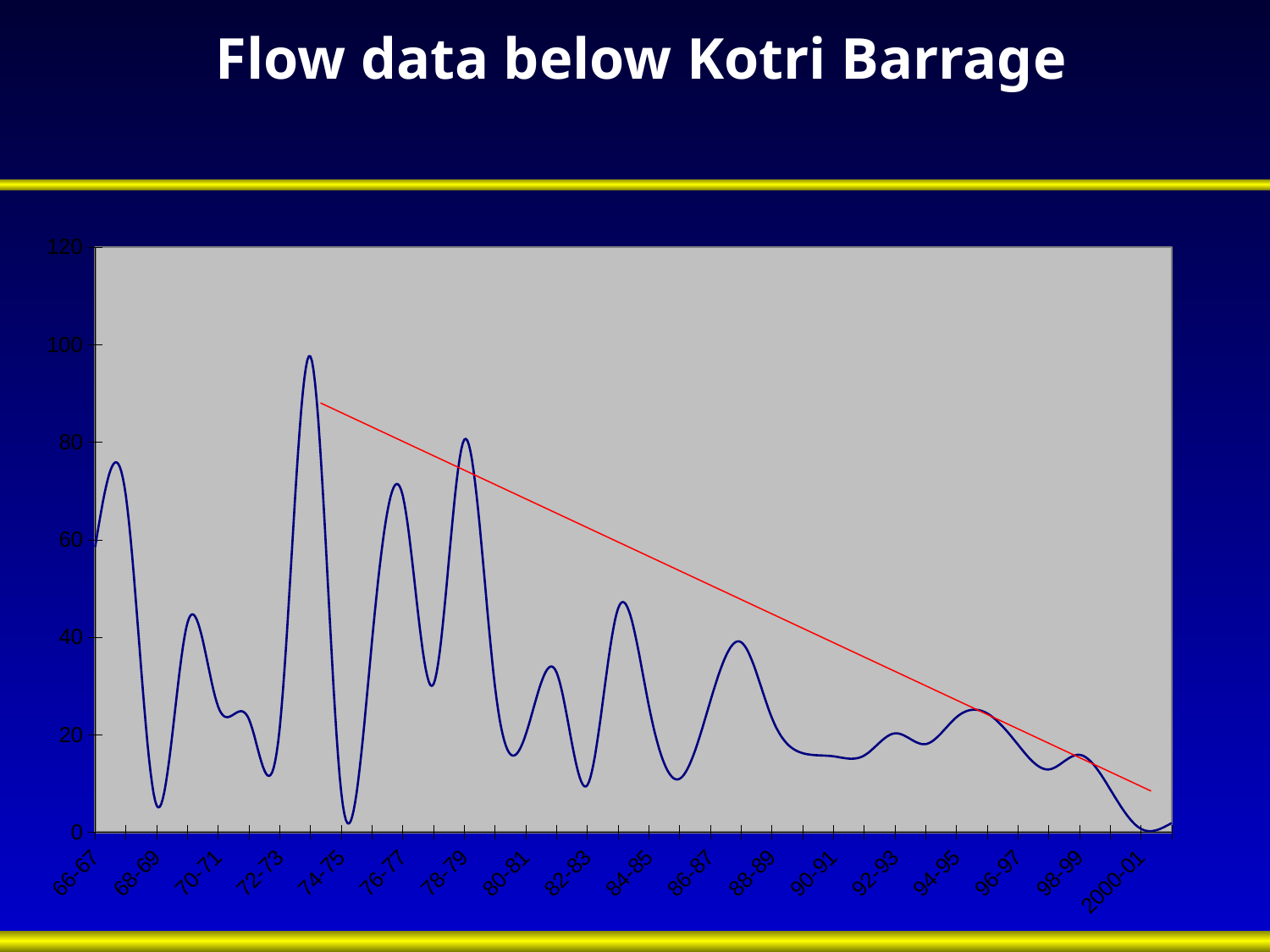
Is the value for 2000-01 greater or less than 20? less Which has the larger value, 78-79 or 68-69? 78-79 What is the title of the chart? Flow data below Kotri Barrage Is the value for 68-69 greater or less than 20? less Is the value for 78-79 greater or less than 60? greater What is the highest value shown on the y axis? 120 Which has the larger value, 66-67 or 2000-01? 66-67 Does the red trend line rise or fall from left to right? fall What kind of chart is shown on the slide? line chart Overall, do the flow values rise or fall across the years shown on the x axis? fall